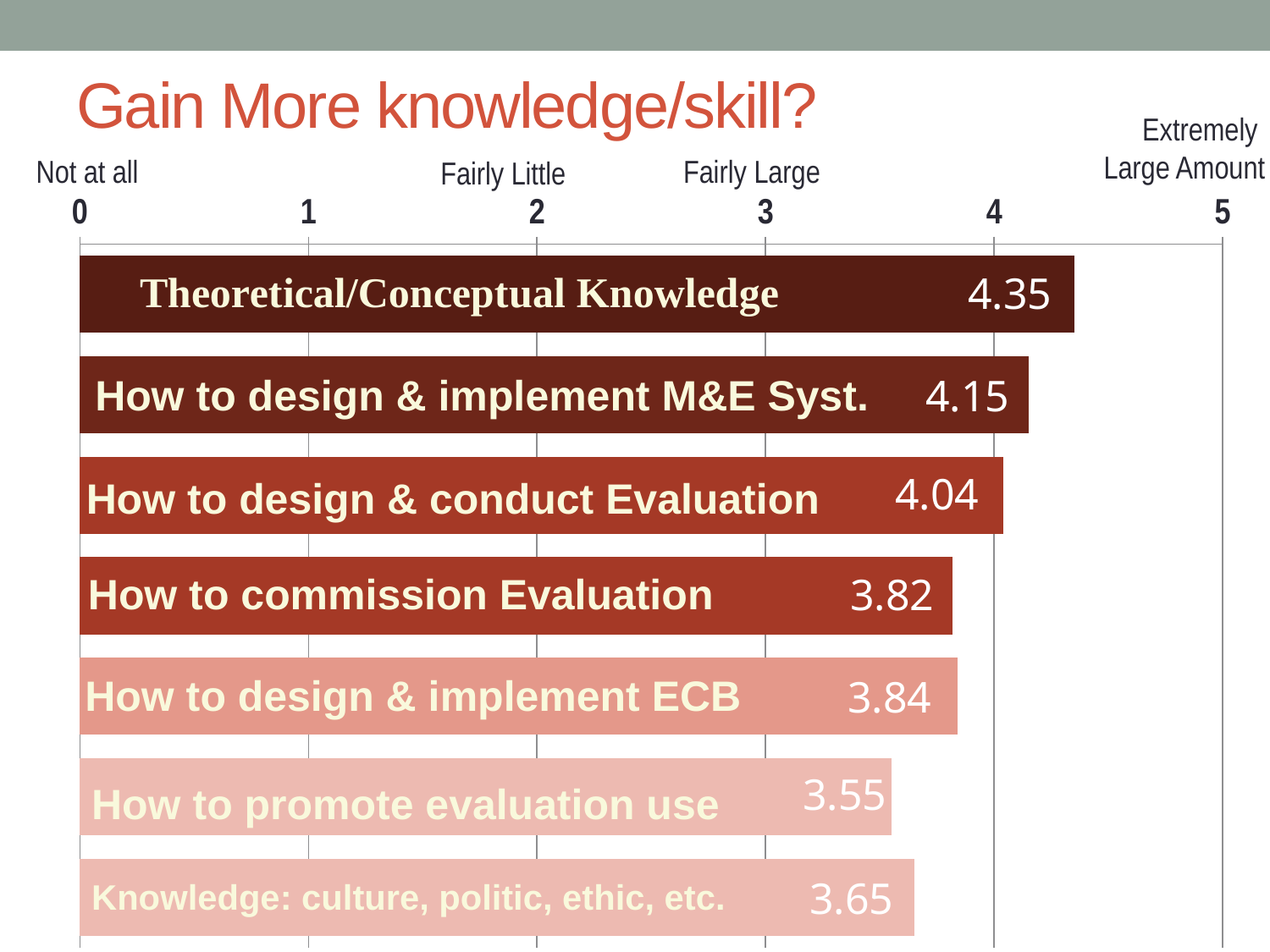
Which category has the lowest value? How to promote evaluation use What is the difference between the values for Theoretical/Conceptual Knowledge and How to design & implement M&E Syst.? 0.20 What is the value for Theoretical/Conceptual Knowledge? 4.35 Which is larger, the value for How to commission Evaluation or the value for How to promote evaluation use? How to commission Evaluation How many categories are shown in the chart? 7 Which category has the highest value? Theoretical/Conceptual Knowledge What is the title of the chart? Gain More knowledge/skill? What is the difference between the values for How to design & conduct Evaluation and How to promote evaluation use? 0.49 What is the value for How to design & implement ECB? 3.84 What kind of chart is shown on the slide? bar chart What is the value for How to promote evaluation use? 3.55 Is the value for Knowledge: culture, politic, ethic, etc. greater or less than 4? less